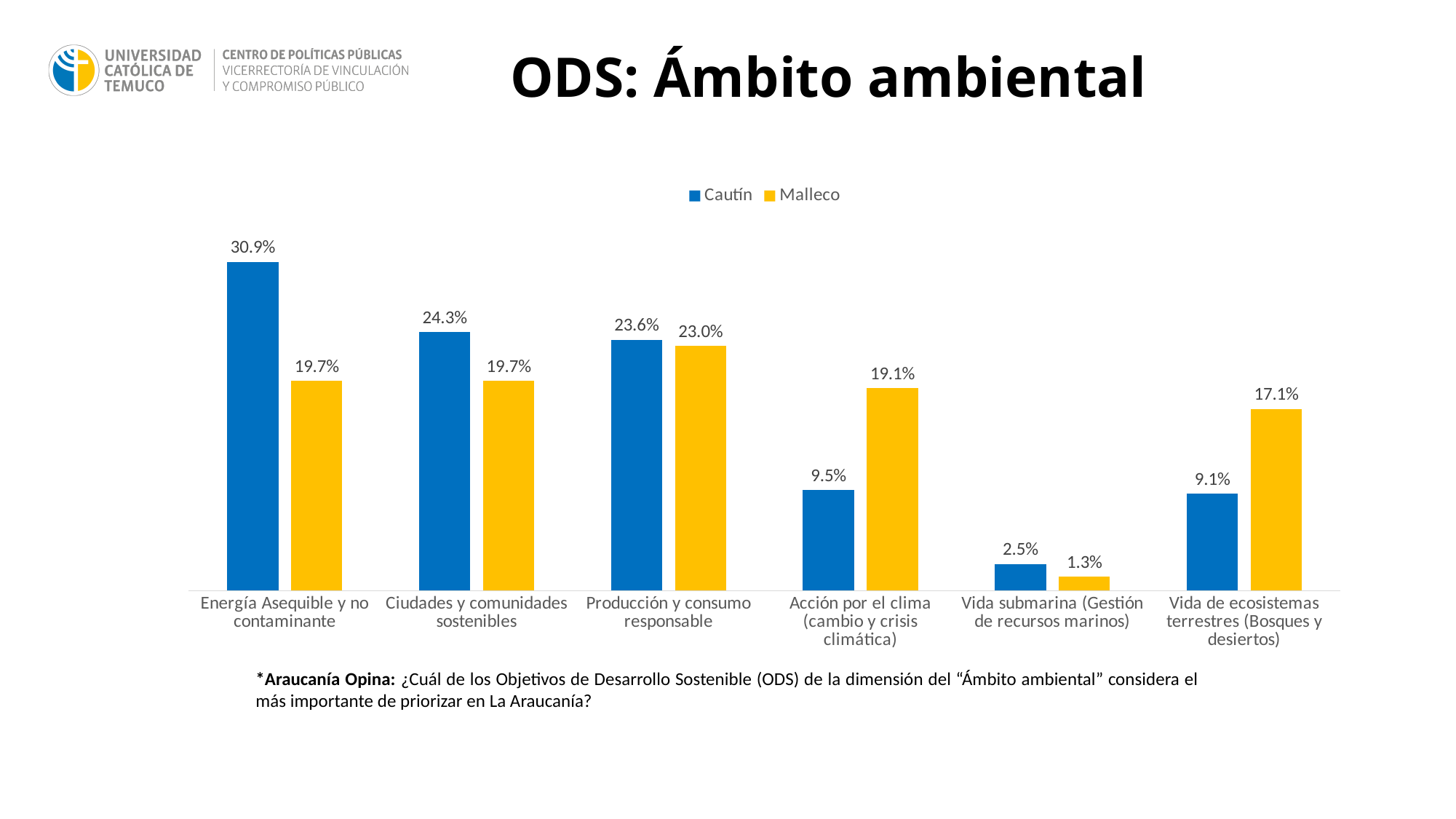
Which is larger for Vida de ecosistemas terrestres (Bosques y desiertos): the Cautín value or the Malleco value? Malleco What is the difference between the Cautín and Malleco values for Energía Asequible y no contaminante? 11.2% How many categories are shown on the x axis? 6 Which category has the highest Cautín value? Energía Asequible y no contaminante What is the Malleco value for Vida submarina (Gestión de recursos marinos)? 1.3% How many series does the legend list? 2 Which category has the lowest Malleco value? Vida submarina (Gestión de recursos marinos) What is the difference between the Cautín and Malleco values for Producción y consumo responsable? 0.6% What is the Malleco value for Acción por el clima (cambio y crisis climática)? 19.1% What kind of chart is shown on the slide? Bar chart What is the Cautín value for Energía Asequible y no contaminante? 30.9% Which colour represents the Malleco series? Yellow